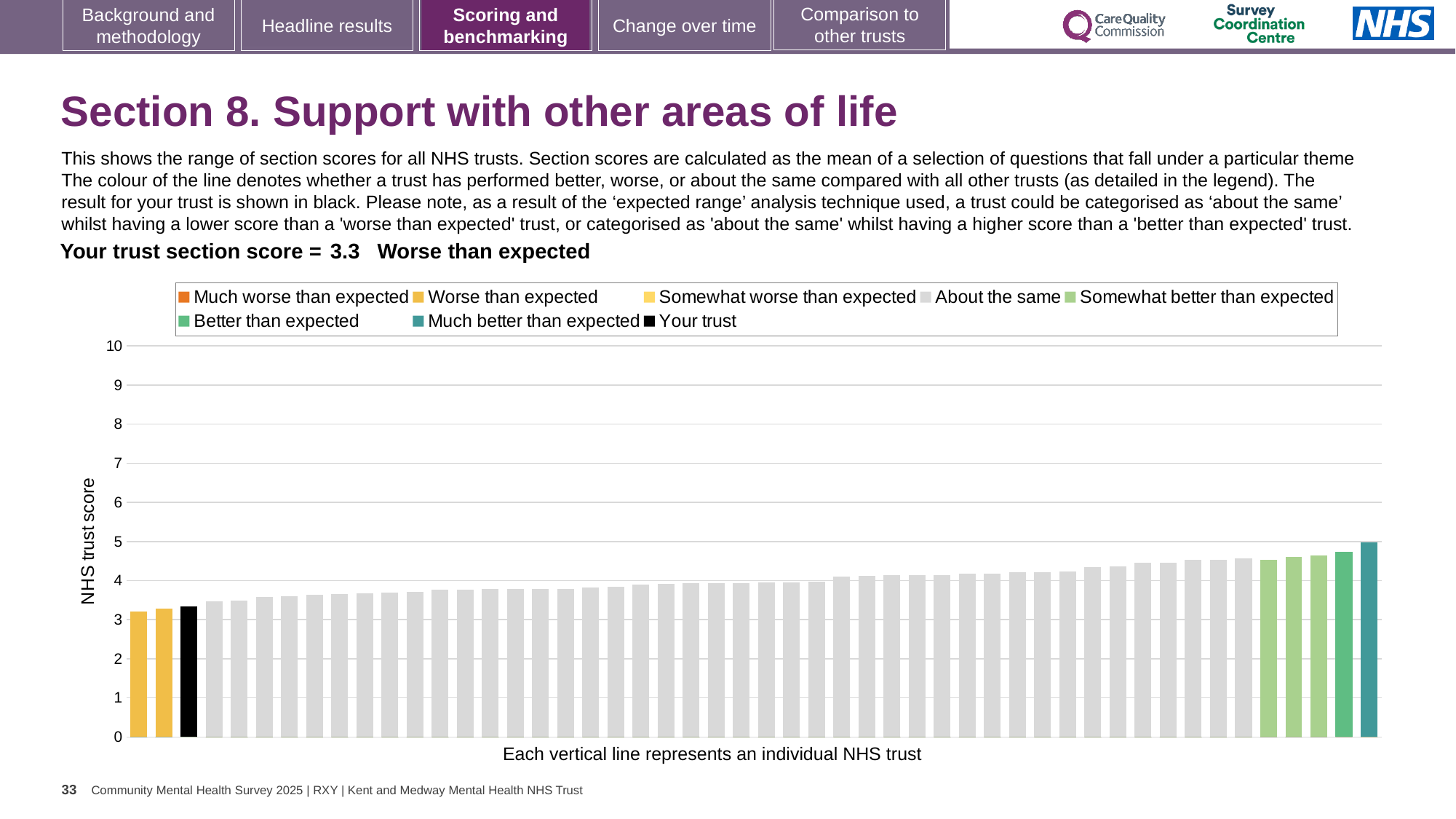
What kind of chart is shown on the slide? Bar chart How many entries does the chart legend list? 8 Is the value of the tallest bar in the chart greater or less than 4? greater How many bars are coloured as 'Worse than expected' (excluding the black 'Your trust' bar)? 2 What colour is used for the 'Your trust' bar in the chart? Black Is the value of the leftmost bar in the chart greater or less than 4? less What is the section score for your trust shown on the slide? 3.3 What is the label on the vertical axis of the chart? NHS trust score Do the bar values rise or fall from left to right across the chart? rise Is the value of the black 'Your trust' bar greater or less than 4? less Which legend category does the tallest bar in the chart belong to? Much better than expected Which performance category is your trust placed in for this section? Worse than expected